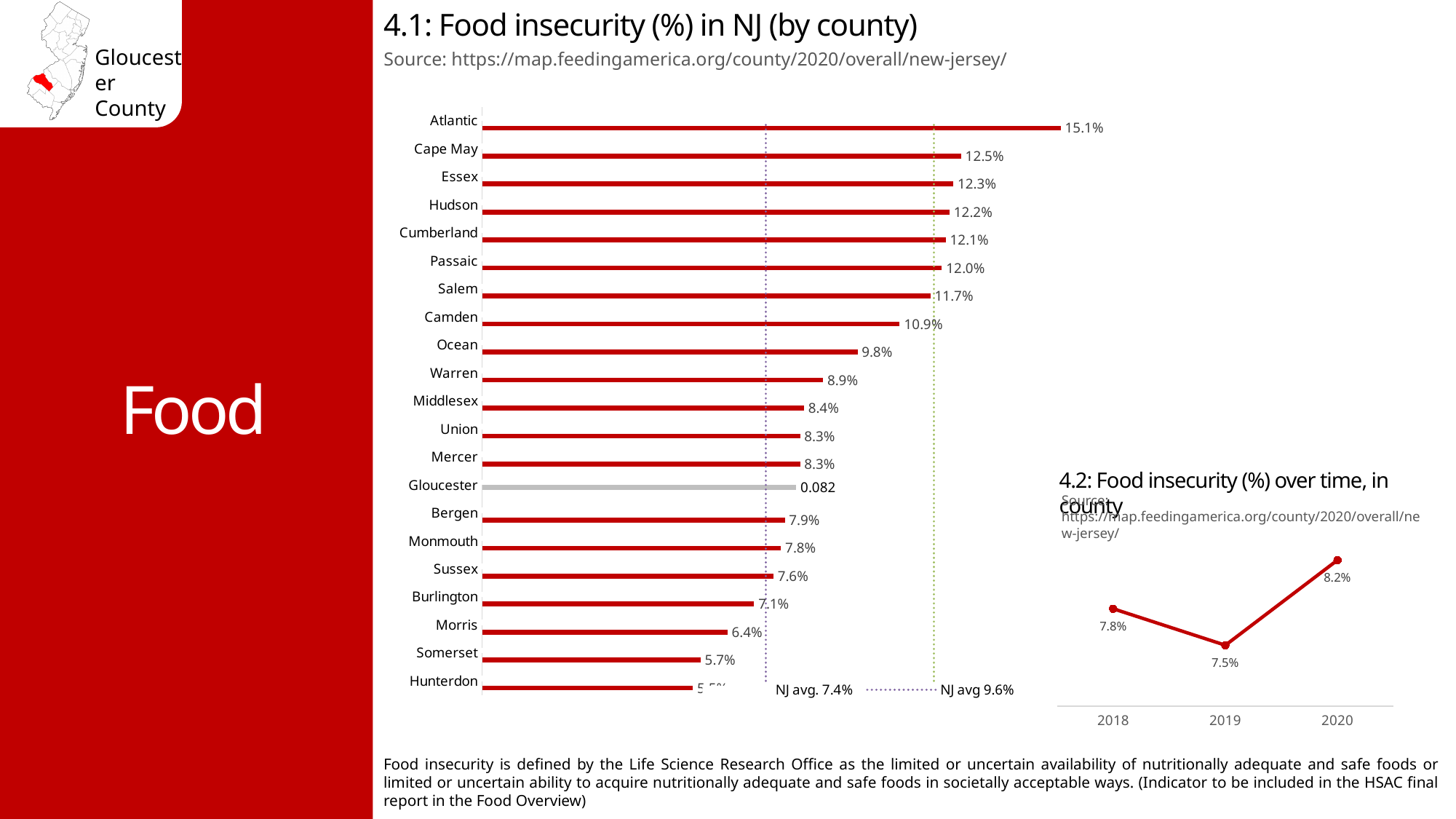
In chart 4.1 (Food insecurity by county), what is the value for Camden? 10.9% In chart 4.1 (Food insecurity by county), what is the data label shown for Gloucester? 0.082 In chart 4.2 (Food insecurity over time), what is the difference between 2020 and 2018? 0.4% What kind of chart is chart 4.1 (Food insecurity by county)? Bar chart In chart 4.1 (Food insecurity by county), what is the difference between Cape May and Essex? 0.2% In chart 4.2 (Food insecurity over time), what is the value for 2019? 7.5% In chart 4.1 (Food insecurity by county), what is the value for Atlantic? 15.1% In chart 4.1 (Food insecurity by county), how many counties are listed? 21 In chart 4.2 (Food insecurity over time), which year has the highest value? 2020 In chart 4.1 (Food insecurity by county), which is larger, Ocean or Warren? Ocean In chart 4.1 (Food insecurity by county), which county has the highest value? Atlantic In chart 4.1 (Food insecurity by county), what NJ average values are marked by the dotted reference lines? 7.4% and 9.6%